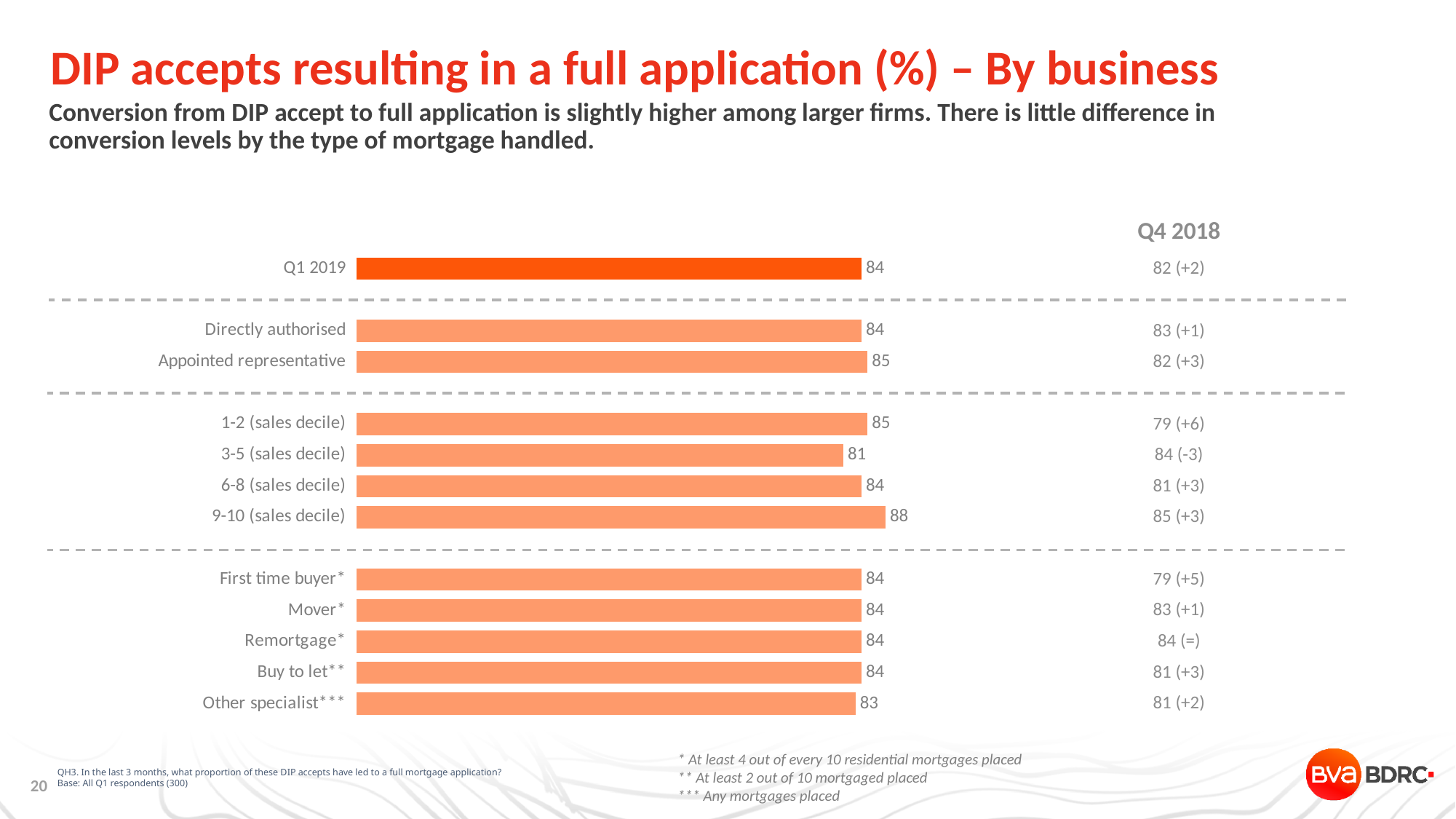
Which category has the highest value? 9-10 (sales decile) What is the value for Appointed representative? 85 What kind of chart is shown on the slide? Bar chart What is the overall Q1 2019 value shown in the chart? 84 What is the value for 3-5 (sales decile)? 81 What Q4 2018 value is listed next to the 1-2 (sales decile) bar? 79 (+6) Which is larger, the value for 1-2 (sales decile) or the value for 3-5 (sales decile)? 1-2 (sales decile) Which category has the lowest value? 3-5 (sales decile) How many bars are plotted in the chart? 12 What is the difference between the values for 9-10 (sales decile) and 3-5 (sales decile)? 7 What is the value for 9-10 (sales decile)? 88 What is the value for Other specialist? 83